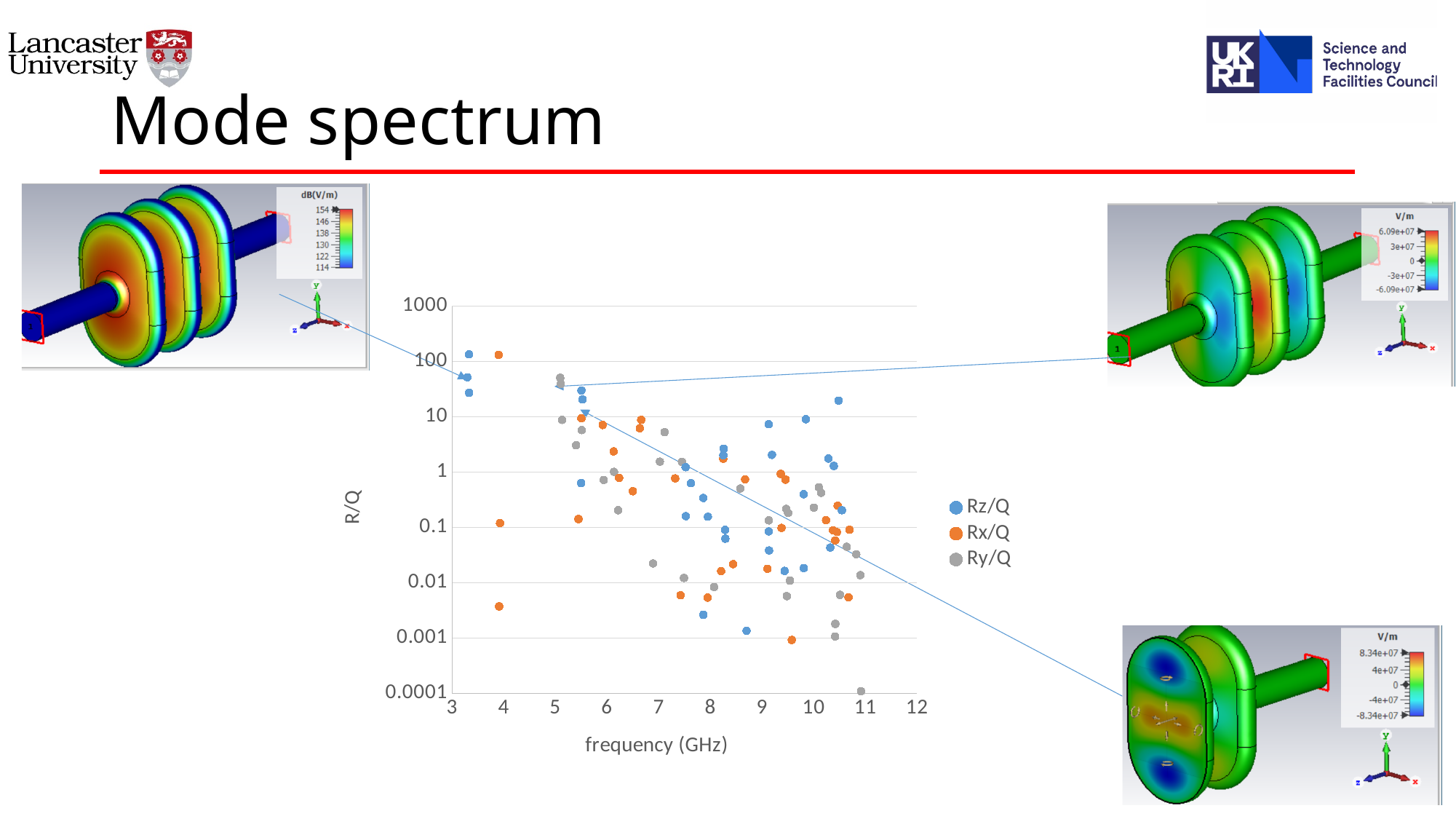
What kind of chart is shown on the slide? scatter chart What is the label of the x axis of the chart? frequency (GHz) What is the label of the y axis of the chart? R/Q Is the highest Ry/Q value on the chart greater or less than 100? less Do the R/Q values generally rise or fall as frequency increases along the x axis? fall What is the highest tick value shown on the y axis of the chart? 1000 What are the three series listed in the chart legend? Rz/Q, Rx/Q, Ry/Q Is the highest Rx/Q value on the chart greater or less than 100? greater Is the highest Rz/Q value on the chart greater or less than 100? greater Which colour represents the Rx/Q series in the chart? orange How many series does the chart legend list? 3